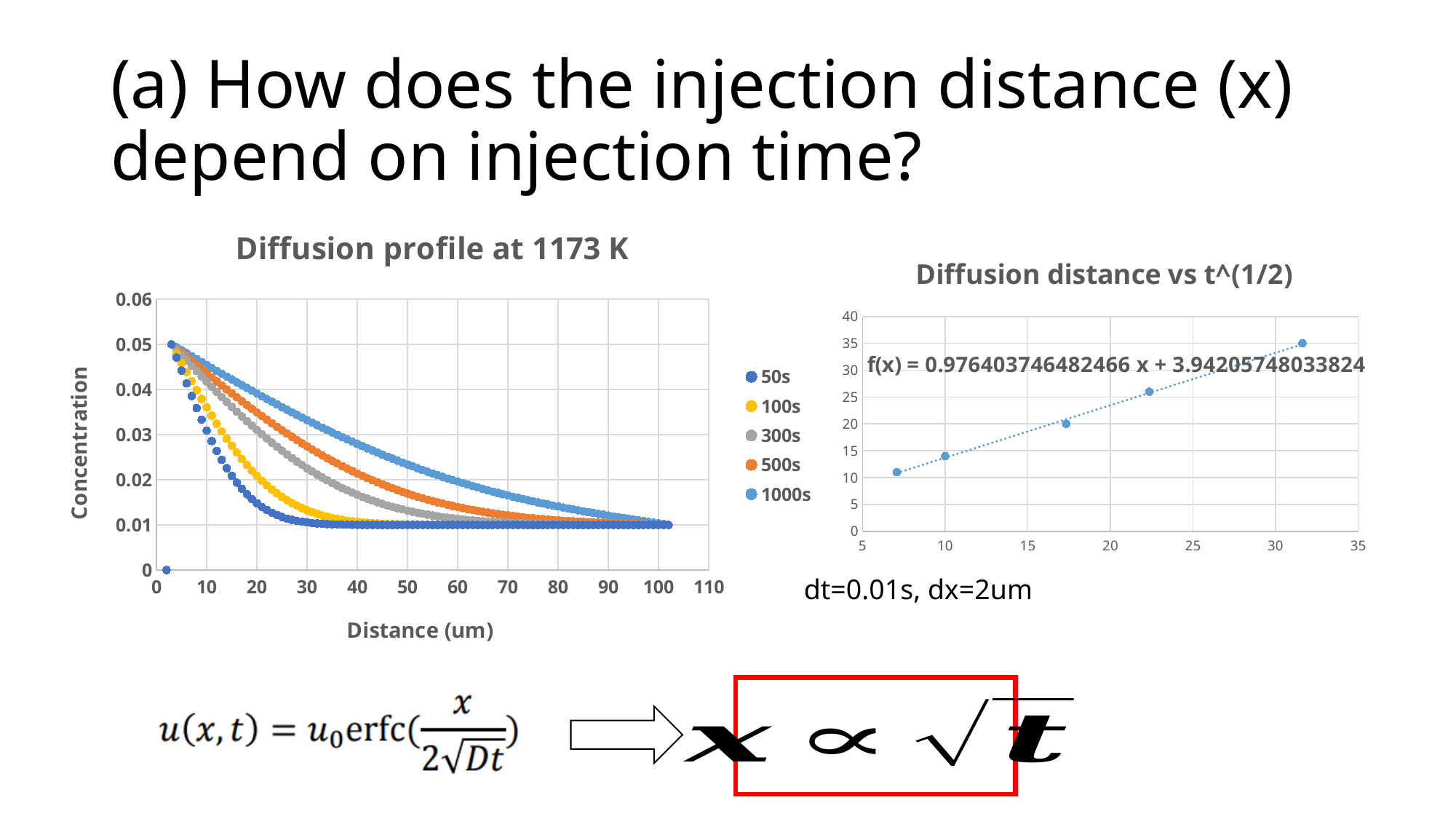
In the 'Diffusion profile at 1173 K' chart, at a distance of 40 um, which series has the higher concentration, 50s or 1000s? 1000s How many data points are plotted in the 'Diffusion distance vs t^(1/2)' chart? 5 How many series does the legend of the 'Diffusion profile at 1173 K' chart list? 5 What kind of chart is the 'Diffusion profile at 1173 K' chart? Scatter chart In the 'Diffusion profile at 1173 K' chart, is the concentration of the 1000s series at a distance of 20 um greater or less than 0.03? greater What is the title of the chart on the right of the slide? Diffusion distance vs t^(1/2) In the 'Diffusion profile at 1173 K' chart, is the concentration of the 50s series at a distance of 20 um greater or less than 0.02? less What is the trendline equation shown on the 'Diffusion distance vs t^(1/2)' chart? f(x) = 0.976403746482466 x + 3.94205748033824 In the 'Diffusion distance vs t^(1/2)' chart, do the values rise or fall as the x value increases? Rise In the 'Diffusion profile at 1173 K' chart, does concentration rise or fall as distance increases? Fall In the 'Diffusion distance vs t^(1/2)' chart, is the value of the rightmost point greater or less than 30? greater In the 'Diffusion profile at 1173 K' chart, what is the label of the x axis? Distance (um)